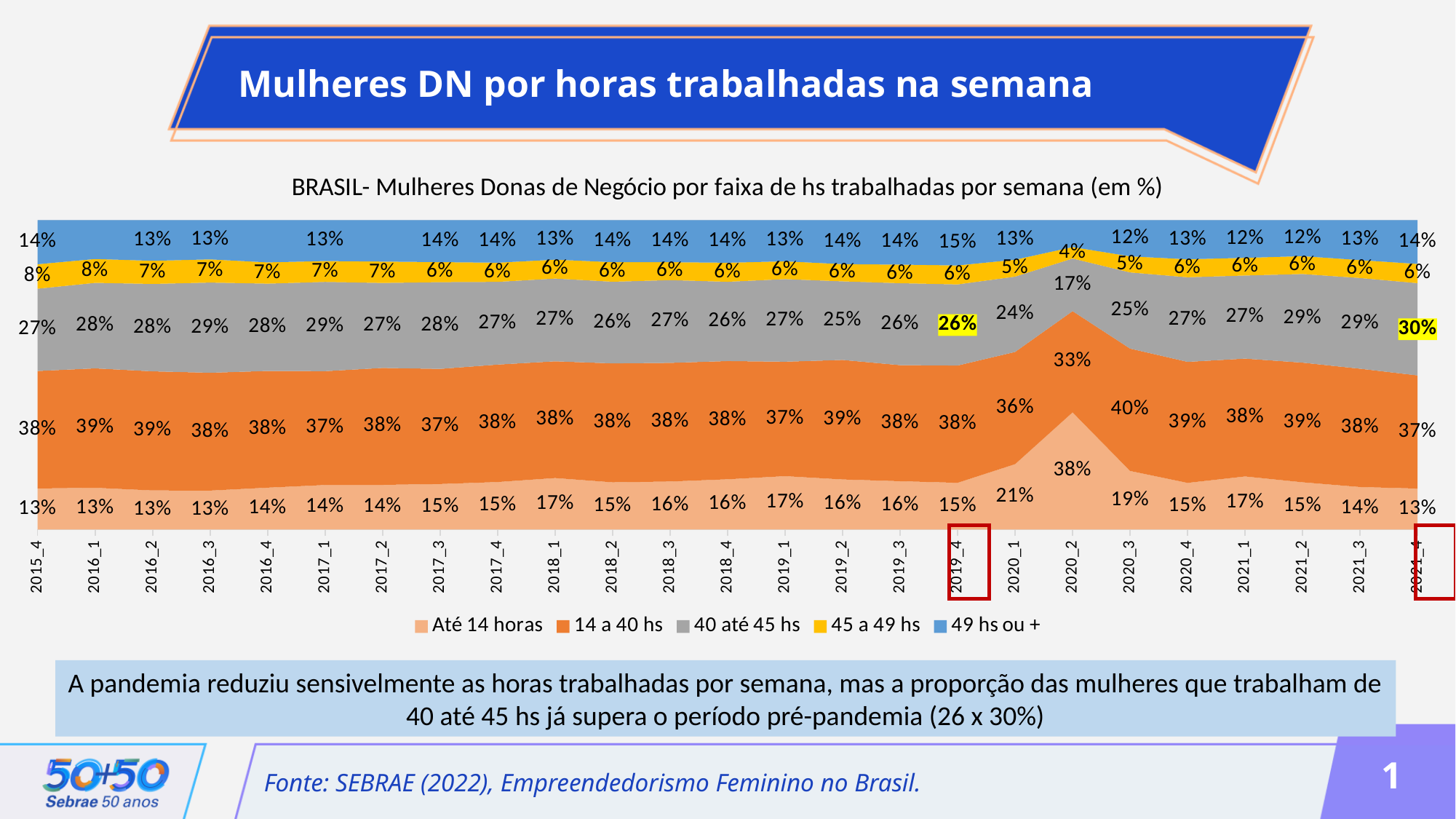
How many quarters (categories) are shown along the x axis? 25 In which quarter does '40 até 45 hs' reach its lowest value? 2020_2 What is the title printed above the chart? BRASIL- Mulheres Donas de Negócio por faixa de hs trabalhadas por semana (em %) What is the value for '40 até 45 hs' in 2021_4? 30% What is the value for '14 a 40 hs' in 2020_3? 40% What is the value for '45 a 49 hs' in 2015_4? 8% What is the difference between the '40 até 45 hs' value in 2021_4 and in 2019_4? 4% What is the value for 'Até 14 horas' in 2020_2? 38% What kind of chart is shown on the slide? Stacked area chart How many series does the legend list? 5 In which quarter does 'Até 14 horas' reach its highest value? 2020_2 Which is larger in 2020_2: the value for '14 a 40 hs' or the value for '40 até 45 hs'? 14 a 40 hs